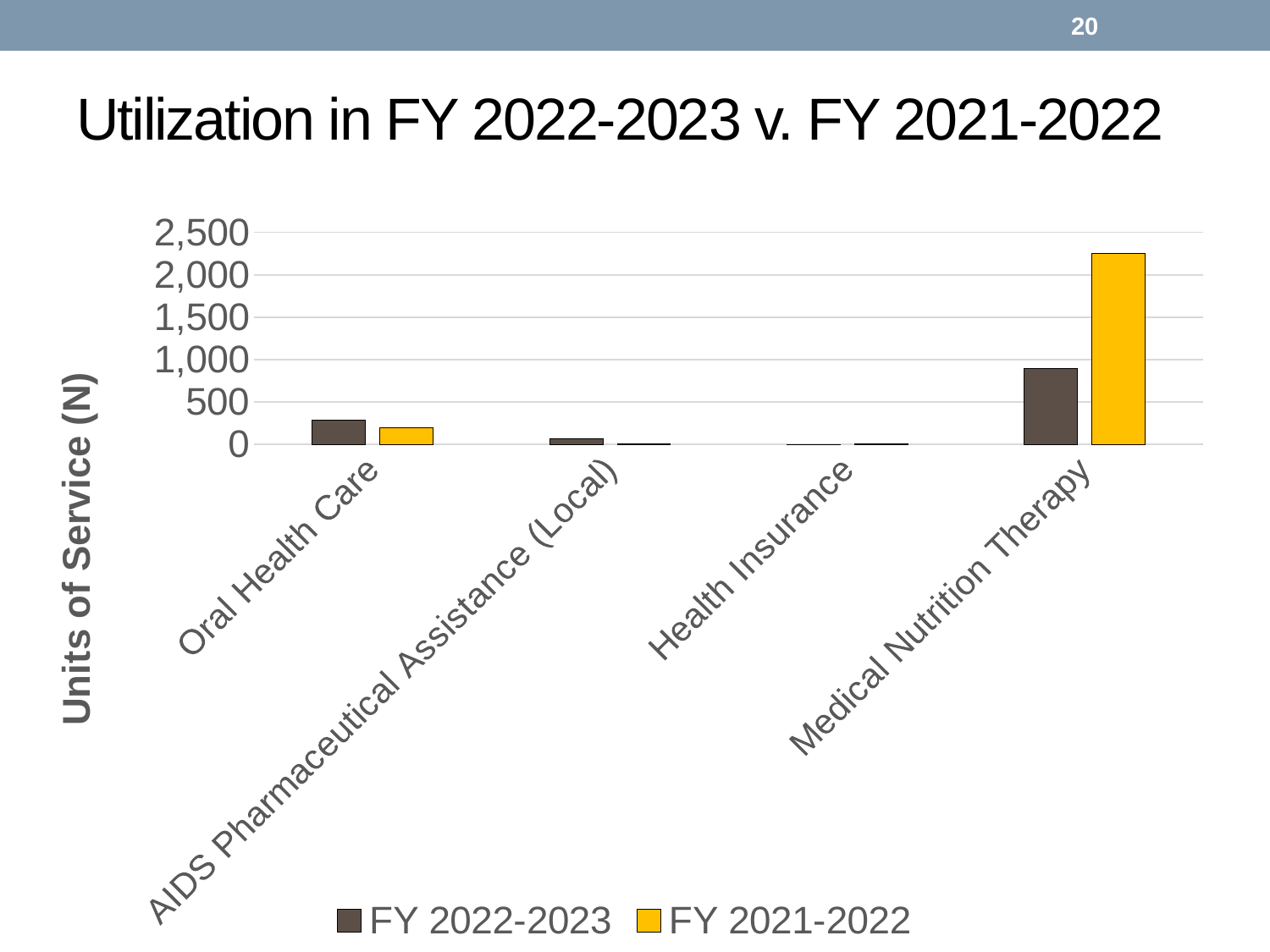
How many series does the legend list? 2 For Medical Nutrition Therapy, which series has the larger value, FY 2022-2023 or FY 2021-2022? FY 2021-2022 Is the FY 2022-2023 value for Oral Health Care greater or less than 500? less Is the FY 2021-2022 value for Medical Nutrition Therapy greater or less than 2,000? greater What kind of chart is shown on the slide? Bar chart Is the FY 2022-2023 value for Medical Nutrition Therapy greater or less than 1,000? less Which category has the highest value for FY 2021-2022? Medical Nutrition Therapy For Oral Health Care, which series has the larger value, FY 2022-2023 or FY 2021-2022? FY 2022-2023 How many service categories are shown on the x axis? 4 What is the title of the y axis? Units of Service (N) Which category has the highest value for FY 2022-2023? Medical Nutrition Therapy Which category has the lowest value for FY 2022-2023? Health Insurance